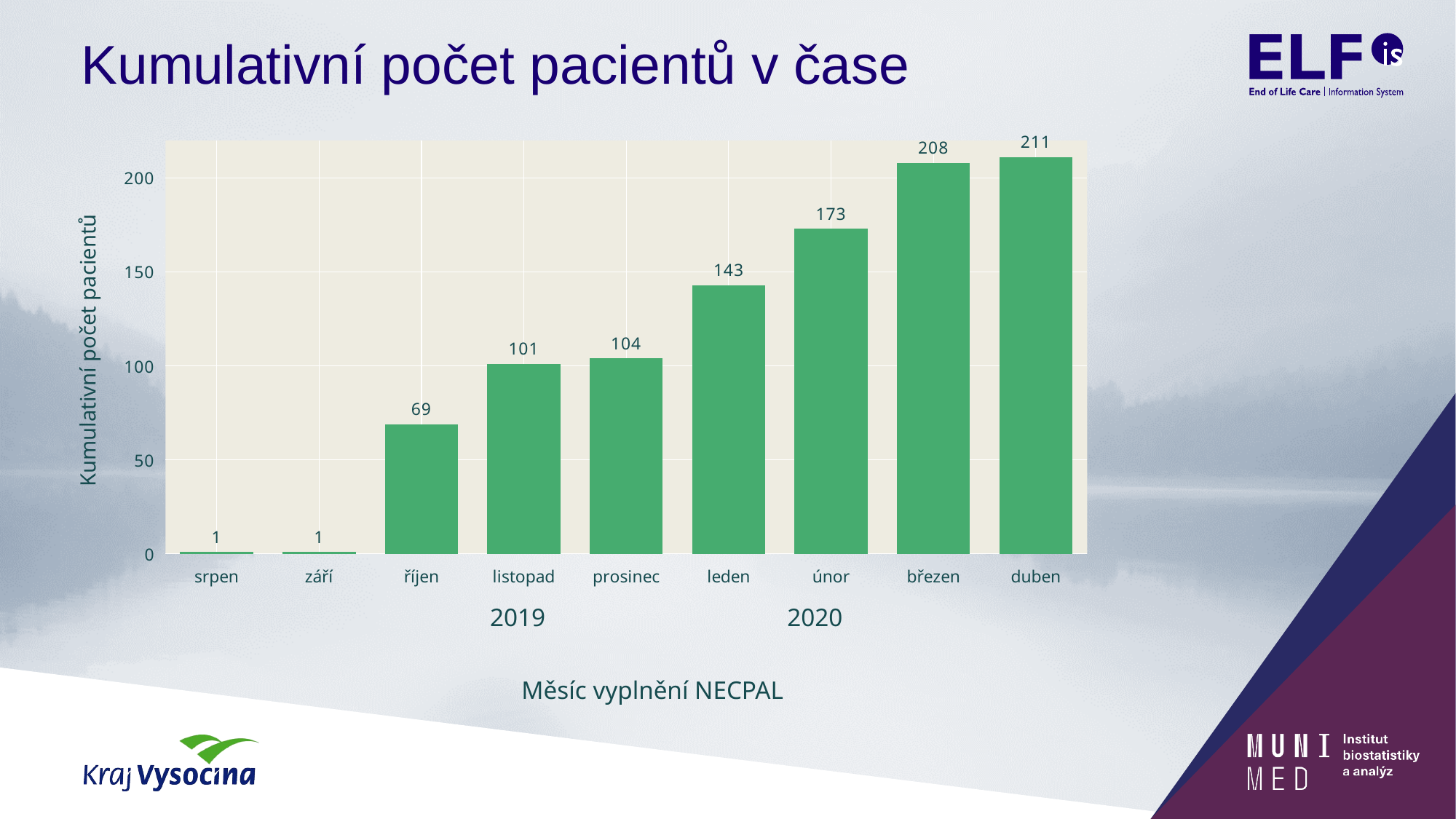
What is the title of the chart? Kumulativní počet pacientů v čase What is the cumulative number of patients for leden? 143 Which is larger, the value for listopad or the value for prosinec? prosinec What is the difference between the values for únor and leden? 30 What is the cumulative number of patients for březen? 208 Which month has the highest cumulative number of patients? duben How many months are shown on the x axis? 9 Do the values rise or fall from srpen to duben? rise What is the cumulative number of patients for říjen? 69 What is the difference between the values for duben and březen? 3 What kind of chart is shown on the slide? bar chart Is the value for únor greater or less than 150? greater